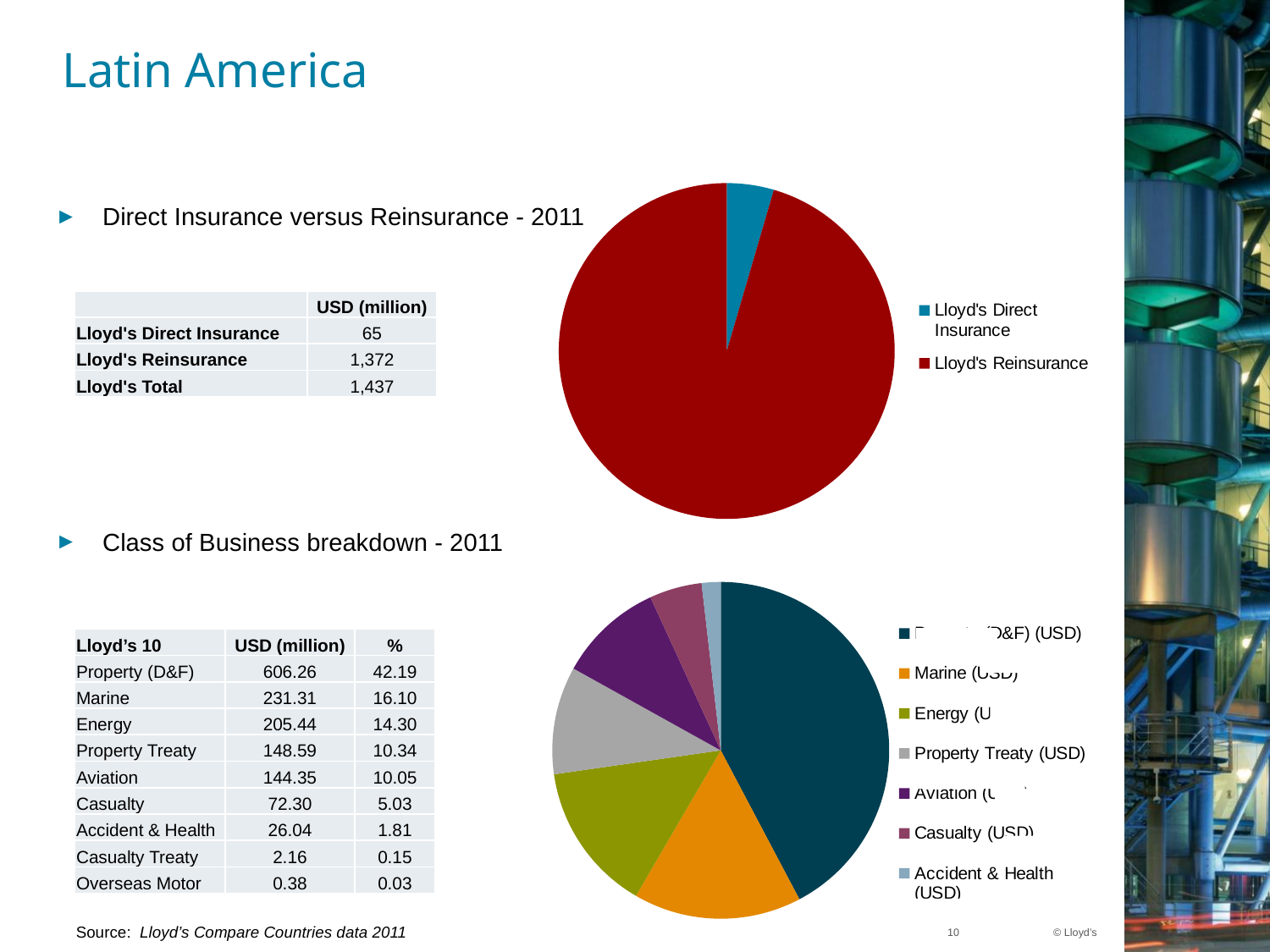
In the 'Class of Business breakdown - 2011' chart, what percentage share does Property (D&F) have? 42.19 In the 'Direct Insurance versus Reinsurance - 2011' chart, what is the value for Lloyd's Direct Insurance in USD (million)? 65 What kind of chart is used for 'Direct Insurance versus Reinsurance - 2011'? Pie chart In the 'Direct Insurance versus Reinsurance - 2011' chart, which category has the larger slice? Lloyd's Reinsurance In the 'Class of Business breakdown - 2011' chart, which is larger, Energy or Casualty? Energy In the 'Class of Business breakdown - 2011' chart, what percentage share does Energy have? 14.30 In the 'Direct Insurance versus Reinsurance - 2011' chart, what is the value for Lloyd's Reinsurance in USD (million)? 1,372 In the 'Class of Business breakdown - 2011' chart, what is the difference in USD (million) between Property Treaty and Aviation? 4.24 How many entries does the legend of the 'Direct Insurance versus Reinsurance - 2011' chart list? 2 In the 'Class of Business breakdown - 2011' chart, what is the value for Marine in USD (million)? 231.31 In the 'Direct Insurance versus Reinsurance - 2011' chart, what is Lloyd's Total in USD (million)? 1,437 In the 'Class of Business breakdown - 2011' chart, which class of business has the largest slice? Property (D&F)